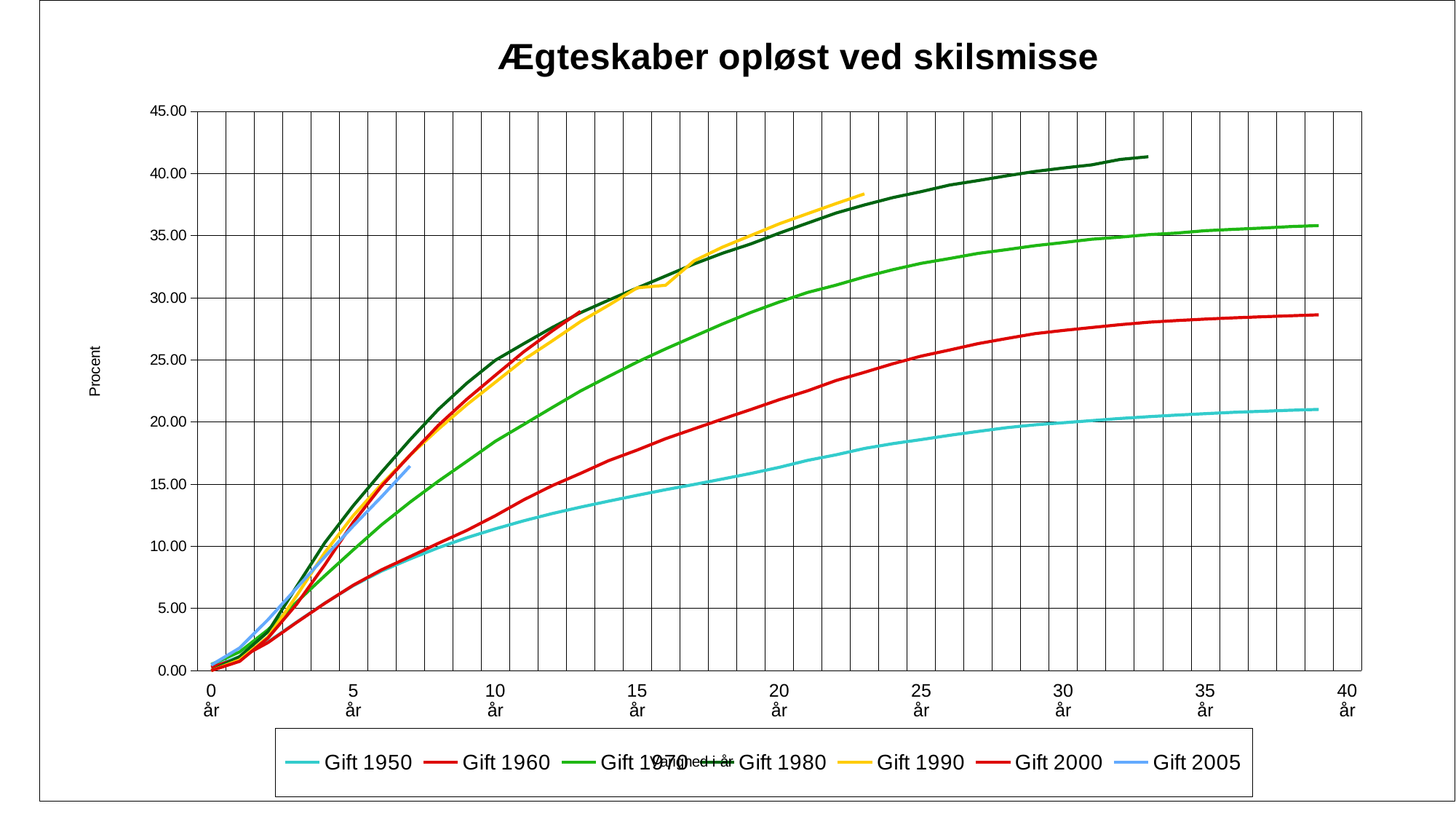
At 20 år, which is larger: Gift 1980 or Gift 1950? Gift 1980 Is the value for Gift 1970 at 39 år greater or less than 35? greater What is the label of the vertical axis? Procent What is the title of the chart? Ægteskaber opløst ved skilsmisse Do the values for Gift 1950 rise or fall as the number of years increases? Rise Is the value for Gift 1960 at 39 år greater or less than 30? less Is the value for Gift 1950 at 39 år greater or less than 20? greater What kind of chart is shown on the slide? Line chart How many series does the legend list? 7 At 20 år, which series has the lowest value? Gift 1950